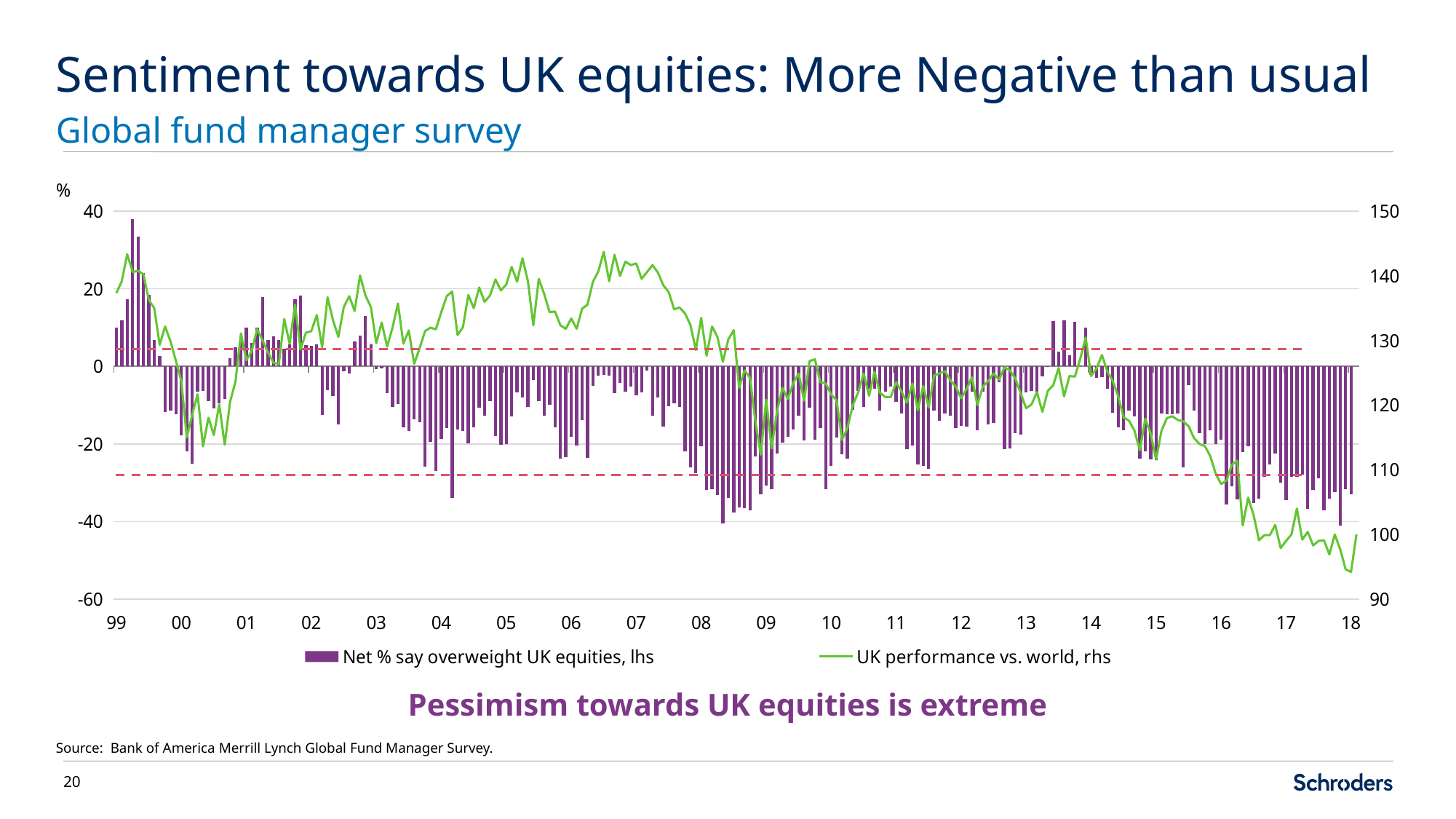
Which series is plotted as a line? UK performance vs. world, rhs In which year on the x axis do the bars for 'Net % say overweight UK equities' reach their highest value? 99 How many series does the legend list? 2 Which series is plotted as bars? Net % say overweight UK equities, lhs Is the lowest point of the 'UK performance vs. world' line greater or less than 100 on the right-hand axis? less In which year on the x axis does the 'UK performance vs. world' line reach its lowest value? 18 How many year labels are shown on the x axis? 20 Is the highest bar for 'Net % say overweight UK equities' greater or less than 20? greater Is the value of the 'UK performance vs. world' line at 99 greater or less than the value at 18? greater What kind of chart is shown on the slide? A combined bar and line chart Is the peak of the 'UK performance vs. world' line around 07 greater or less than 140 on the right-hand axis? greater Does the 'UK performance vs. world' line rise or fall between 14 and 18? fall